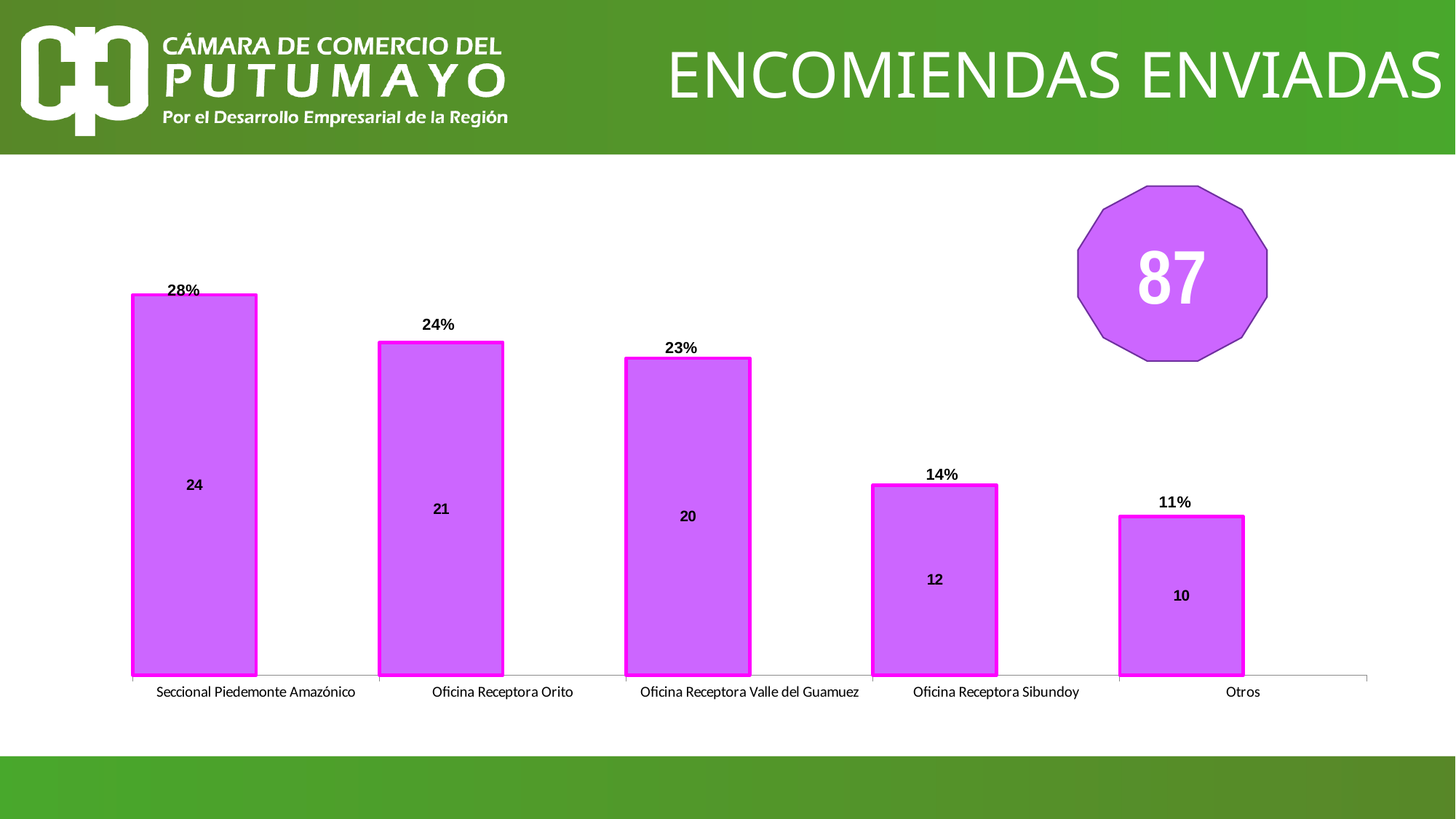
What is the difference between the values for Seccional Piedemonte Amazónico and Oficina Receptora Valle del Guamuez? 4 How many categories are shown on the x axis? 5 Which is larger, the value for Oficina Receptora Sibundoy or the value for Otros? Oficina Receptora Sibundoy What percentage is shown above the bar for Oficina Receptora Sibundoy? 14% What is the value shown inside the bar for Oficina Receptora Orito? 21 What kind of chart is shown on the slide? Bar chart What percentage is shown above the bar for Seccional Piedemonte Amazónico? 28% What number is shown in the purple shape at the top right of the slide? 87 What is the value shown inside the bar for Otros? 10 Do the bar values rise or fall from left to right along the x axis? Fall Which category has the lowest bar? Otros Which category has the highest bar? Seccional Piedemonte Amazónico